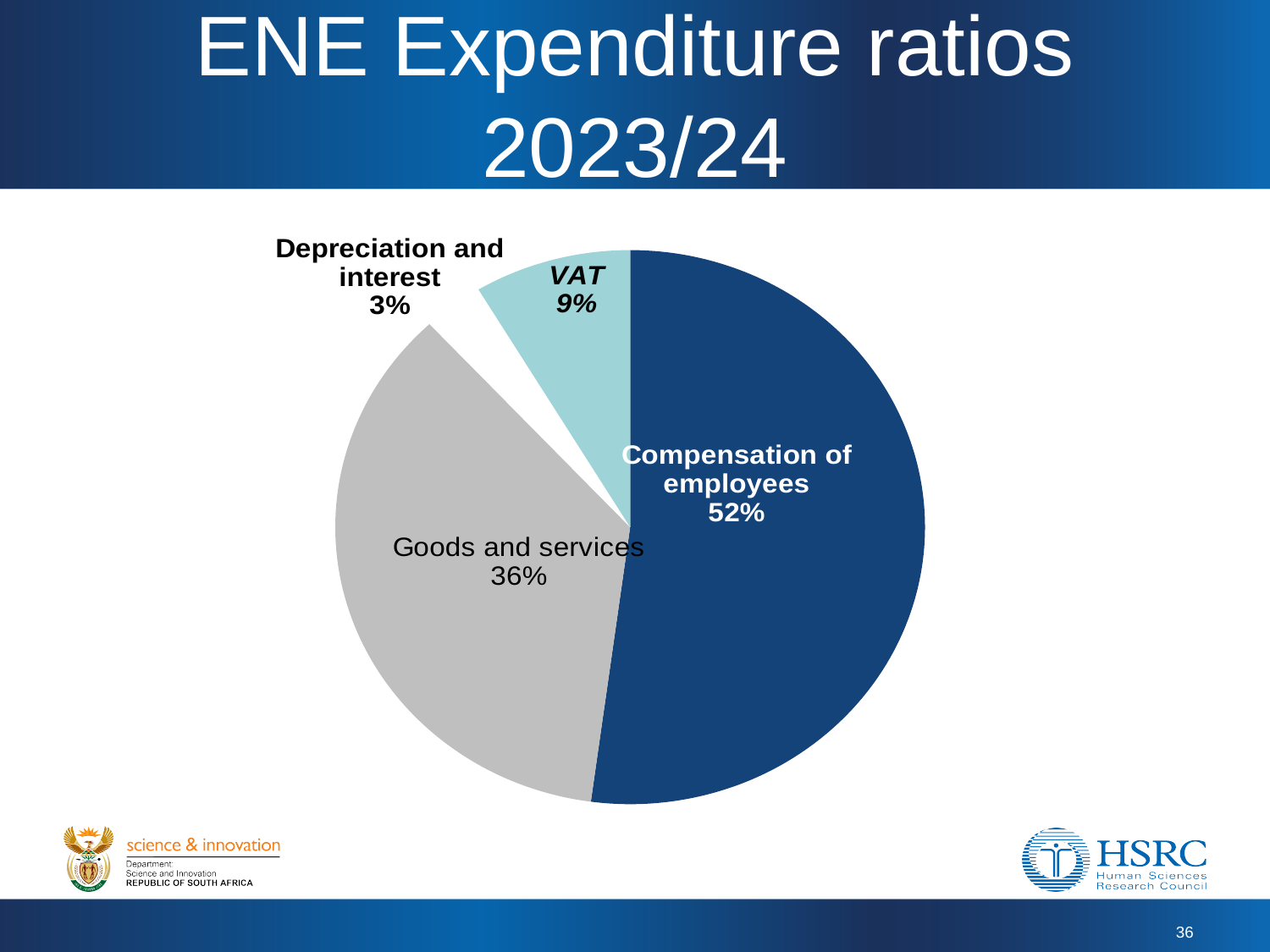
What share of expenditure is Goods and services? 36% How many categories are shown in the pie chart? 4 What is the combined share of VAT and Depreciation and interest? 12% What is the difference in percentage points between Compensation of employees and Goods and services? 16 Which category has the smallest share of the pie? Depreciation and interest What share of expenditure is Compensation of employees? 52% What is the title of the slide containing the chart? ENE Expenditure ratios 2023/24 What share of expenditure is Depreciation and interest? 3% What kind of chart is shown on the slide? pie chart What share of expenditure is VAT? 9% Which is larger, VAT or Depreciation and interest? VAT Which category has the largest share of the pie? Compensation of employees